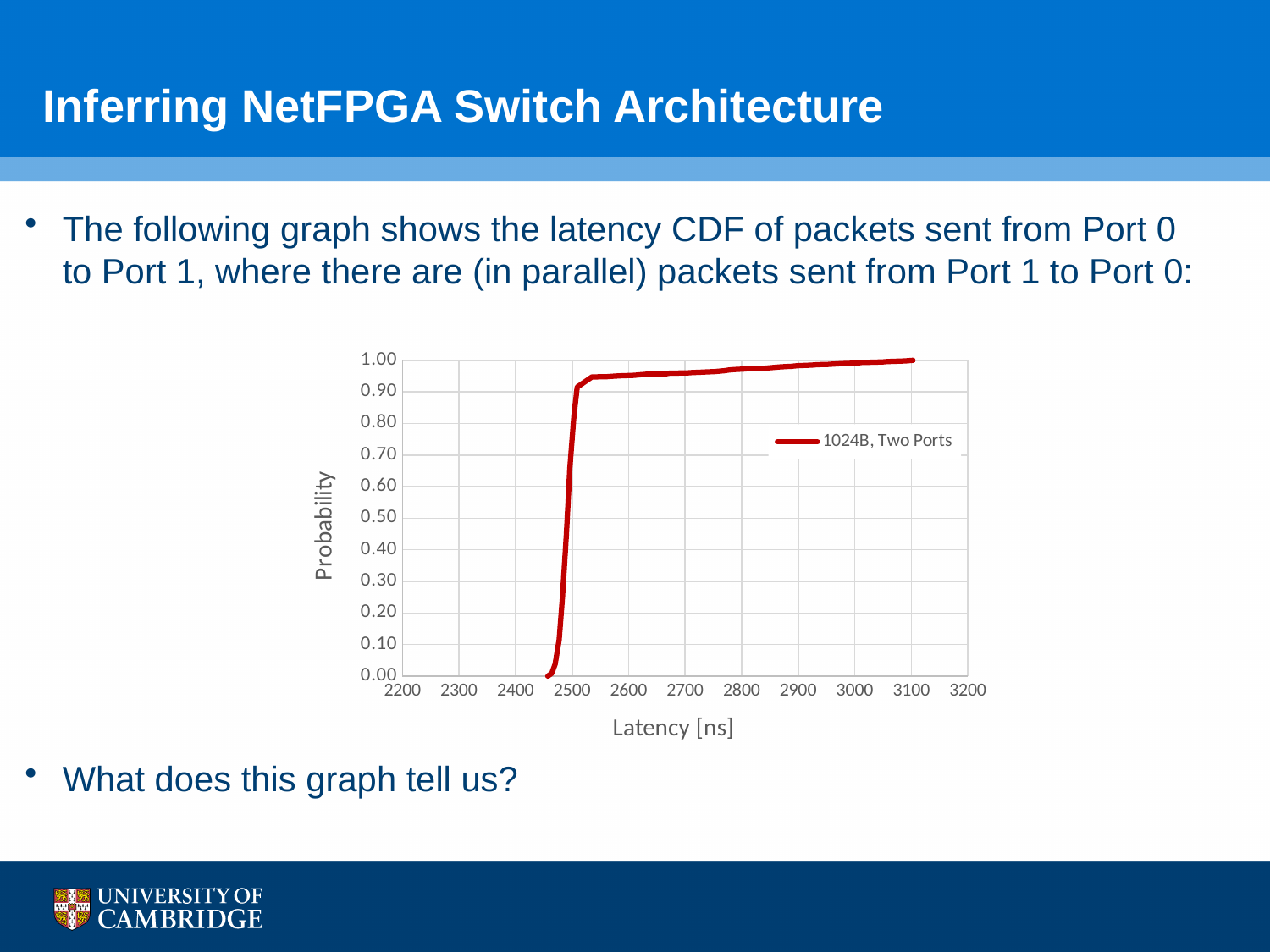
How many series does the legend list? 1 What is the title of the x axis? Latency [ns] What kind of chart is shown on the slide? line chart Is the probability at a latency of 2600 ns greater or less than 0.90? greater Is the probability at a latency of 3000 ns greater or less than 0.90? greater Is the probability at a latency of 2450 ns greater or less than 0.10? less What is the name of the series shown in the legend? 1024B, Two Ports Which has the larger probability: a latency of 2600 ns or a latency of 2450 ns? 2600 ns Do the plotted probability values rise or fall as latency increases along the x axis? rise